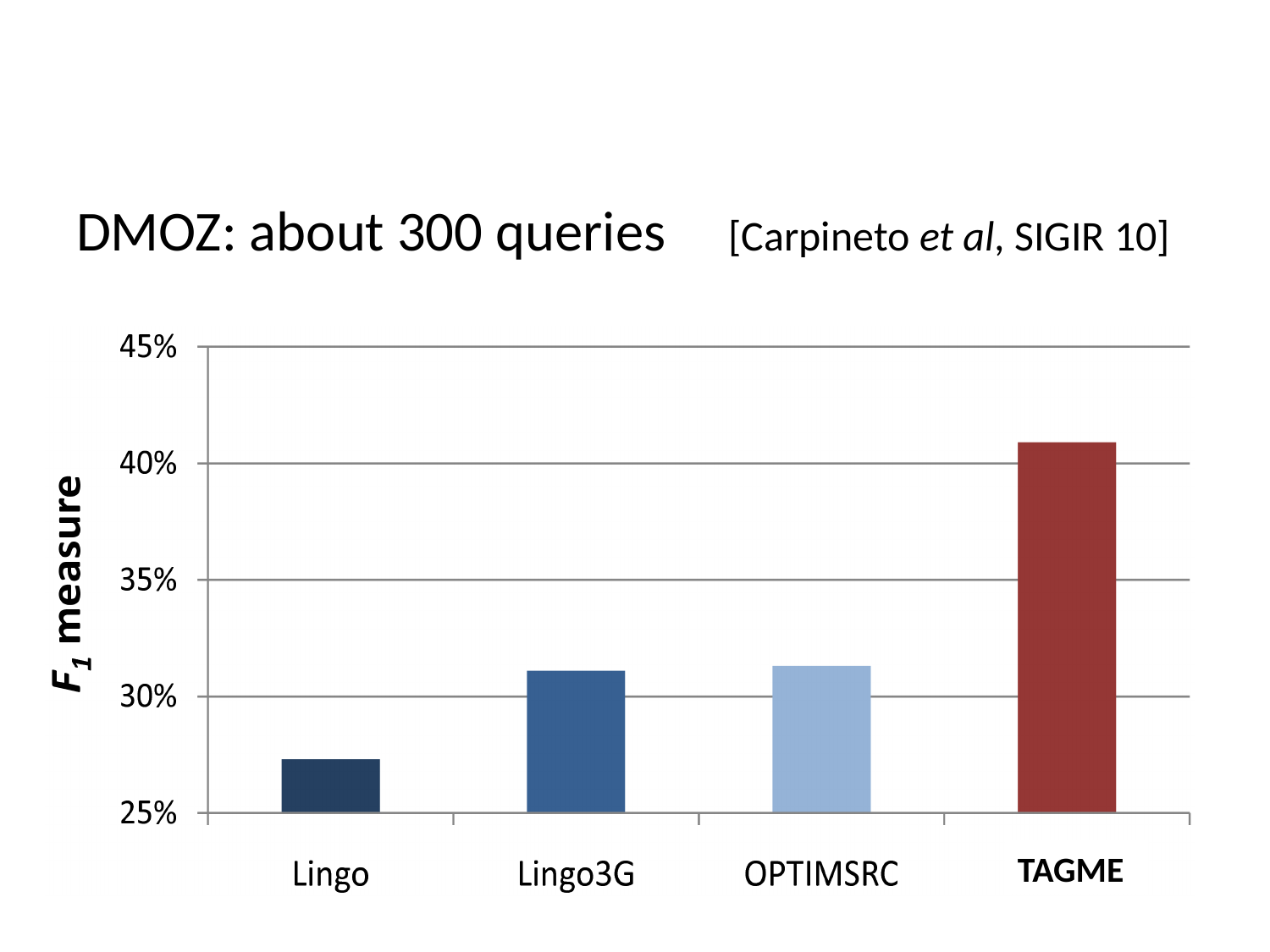
Is the value for Lingo greater or less than 30%? less How many categories are plotted on the x axis? 4 Which has a lower F1 measure, Lingo or Lingo3G? Lingo Which has a higher F1 measure, TAGME or OPTIMSRC? TAGME Is the value for OPTIMSRC greater or less than 35%? less Is the value for TAGME greater or less than 40%? greater What kind of chart is shown on the slide? bar chart Which category has the lowest F1 measure? Lingo Which category has the highest F1 measure? TAGME What is the label of the y axis? F1 measure What colour is the bar for TAGME? red